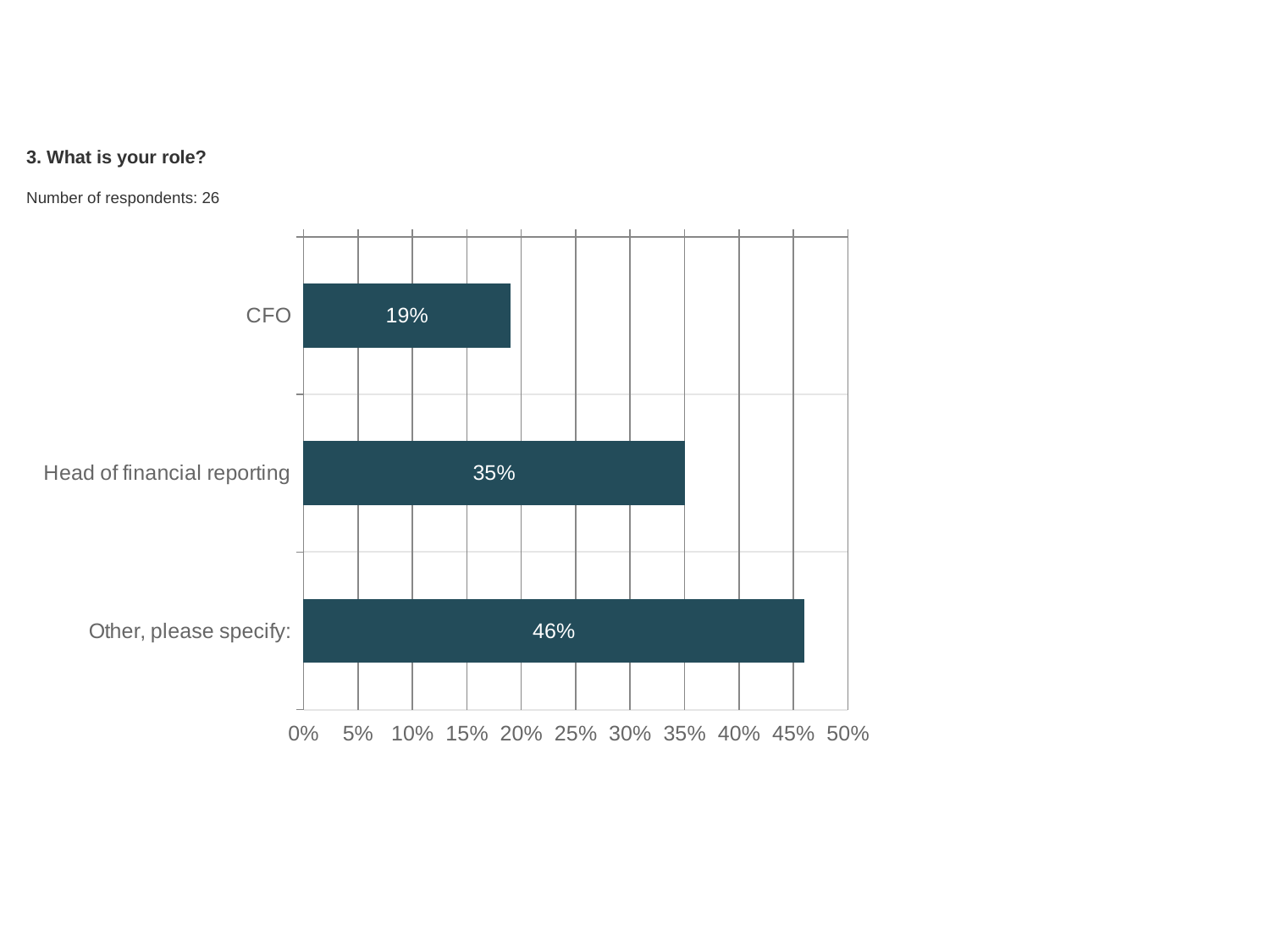
What is the difference between the values for Other, please specify and CFO? 27% What percentage of respondents are CFOs? 19% Which role has the highest percentage of respondents? Other, please specify: What is the difference between the values for Head of financial reporting and CFO? 16% Which is larger, the value for CFO or the value for Head of financial reporting? Head of financial reporting How many role categories are shown in the chart? 3 Which role has the lowest percentage of respondents? CFO What kind of chart is shown on the slide? Bar chart What is the value for Head of financial reporting? 35% Is the value for Other, please specify greater or less than 40%? greater What is the value for Other, please specify? 46% How many respondents answered the question shown on the slide? 26